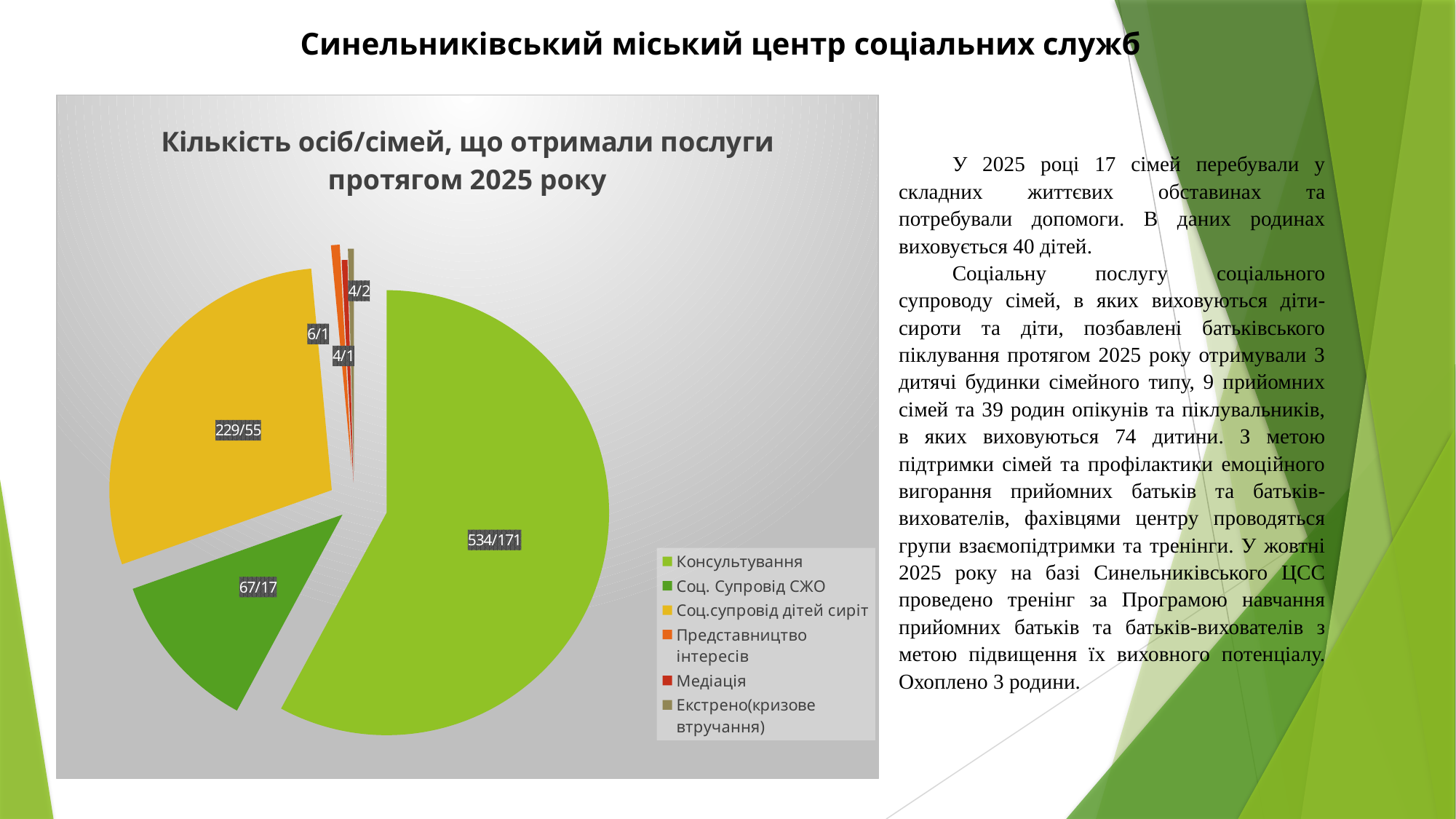
What is the data label shown for the Соц.супровід дітей сиріт slice? 229/55 What is the data label shown for the Представництво інтересів slice? 6/1 How many categories are shown in the pie chart? 6 What is the data label shown for the Соц. Супровід СЖО slice? 67/17 Which slice is larger: Соц.супровід дітей сиріт or Соц. Супровід СЖО? Соц.супровід дітей сиріт Which category has the largest slice of the pie? Консультування How many entries does the legend list? 6 What is the data label shown for the Консультування slice? 534/171 What kind of chart is shown on the slide? pie chart What is the title of the chart? Кількість осіб/сімей, що отримали послуги протягом 2025 року What is the data label shown for the Медіація slice? 4/1 What is the data label shown for the Екстрено(кризове втручання) slice? 4/2